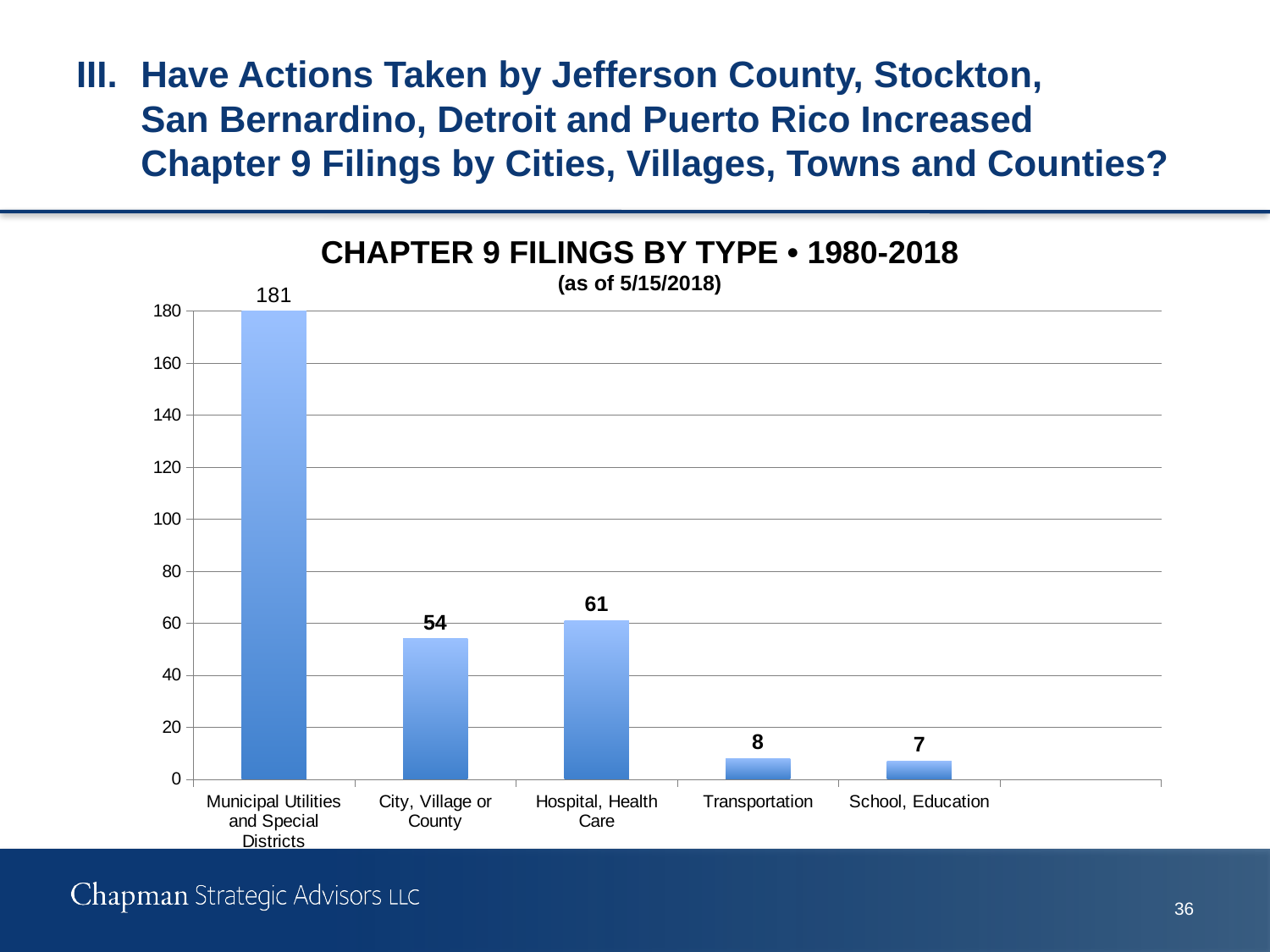
Which category has the highest number of filings? Municipal Utilities and Special Districts Which category has the lowest number of filings? School, Education Which is larger, the value for Hospital, Health Care or the value for City, Village or County? Hospital, Health Care What is the value for Transportation? 8 Is the value for City, Village or County greater or less than 60? less What is the title of the chart? CHAPTER 9 FILINGS BY TYPE • 1980-2018 What is the difference between the values for Municipal Utilities and Special Districts and Hospital, Health Care? 120 What is the value for Hospital, Health Care? 61 What kind of chart is shown on the slide? bar chart What is the value for City, Village or County? 54 How many categories are shown on the x axis? 5 What is the value for Municipal Utilities and Special Districts? 181